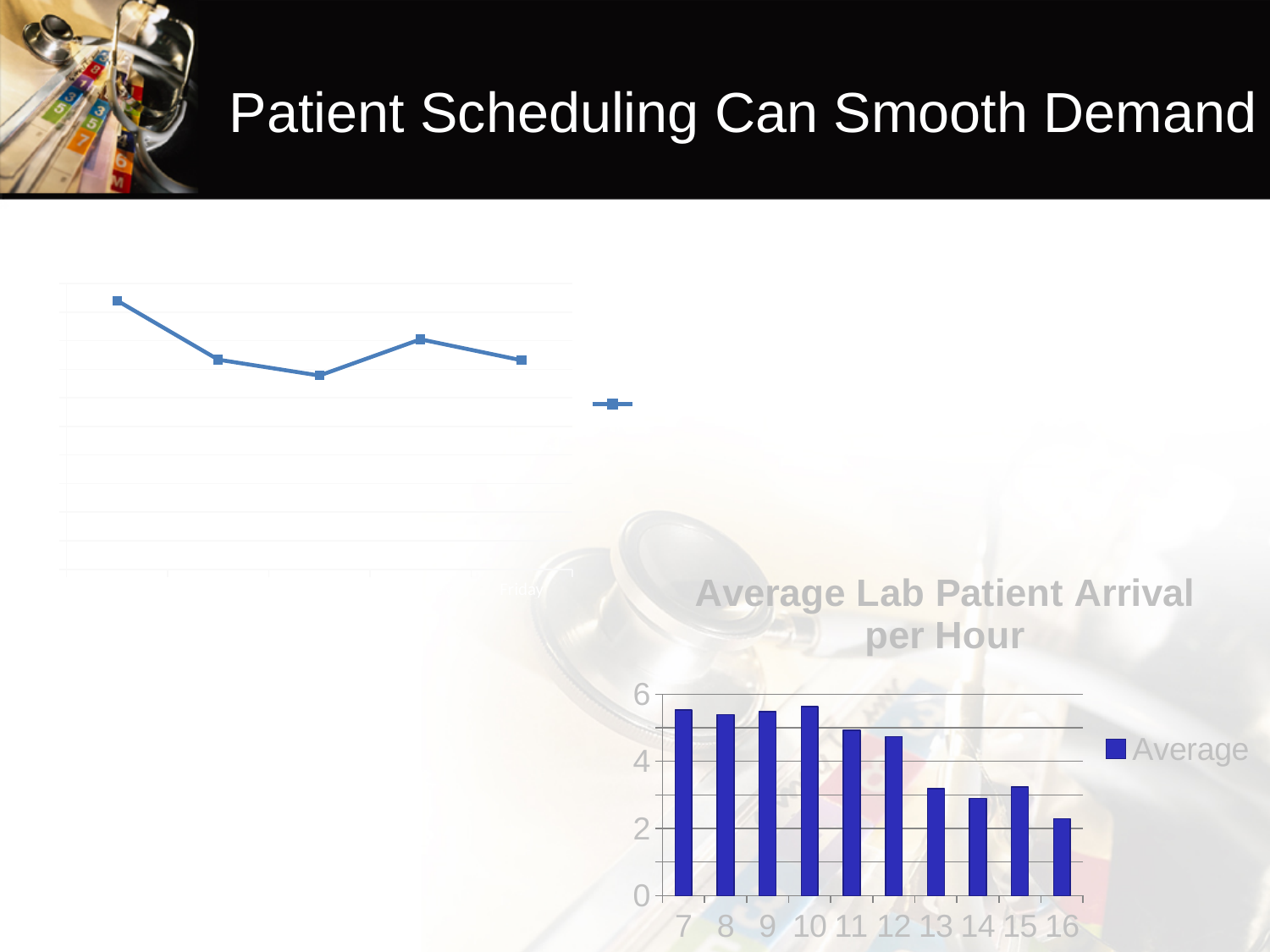
In the 'Average Lab Patient Arrival per Hour' chart, is the value for hour 14 greater or less than 4? less In the 'Average Lab Patient Arrival per Hour' chart, which is larger, the value for hour 12 or hour 13? hour 12 In the 'Average Lab Patient Arrival per Hour' chart, how many hours are shown on the x axis? 10 What kind of chart is the chart at the top left of the slide? line chart What is the legend entry in the 'Average Lab Patient Arrival per Hour' chart? Average How many series does the legend of the 'Average Lab Patient Arrival per Hour' chart list? 1 In the 'Average Lab Patient Arrival per Hour' chart, is the value for hour 16 greater or less than 2? greater In the 'Average Lab Patient Arrival per Hour' chart, do the values generally rise or fall from hour 7 to hour 16? fall In the 'Average Lab Patient Arrival per Hour' chart, which hour has the lowest average arrival? 16 In the 'Average Lab Patient Arrival per Hour' chart, is the value for hour 7 greater or less than 4? greater What kind of chart is the 'Average Lab Patient Arrival per Hour' chart? bar chart